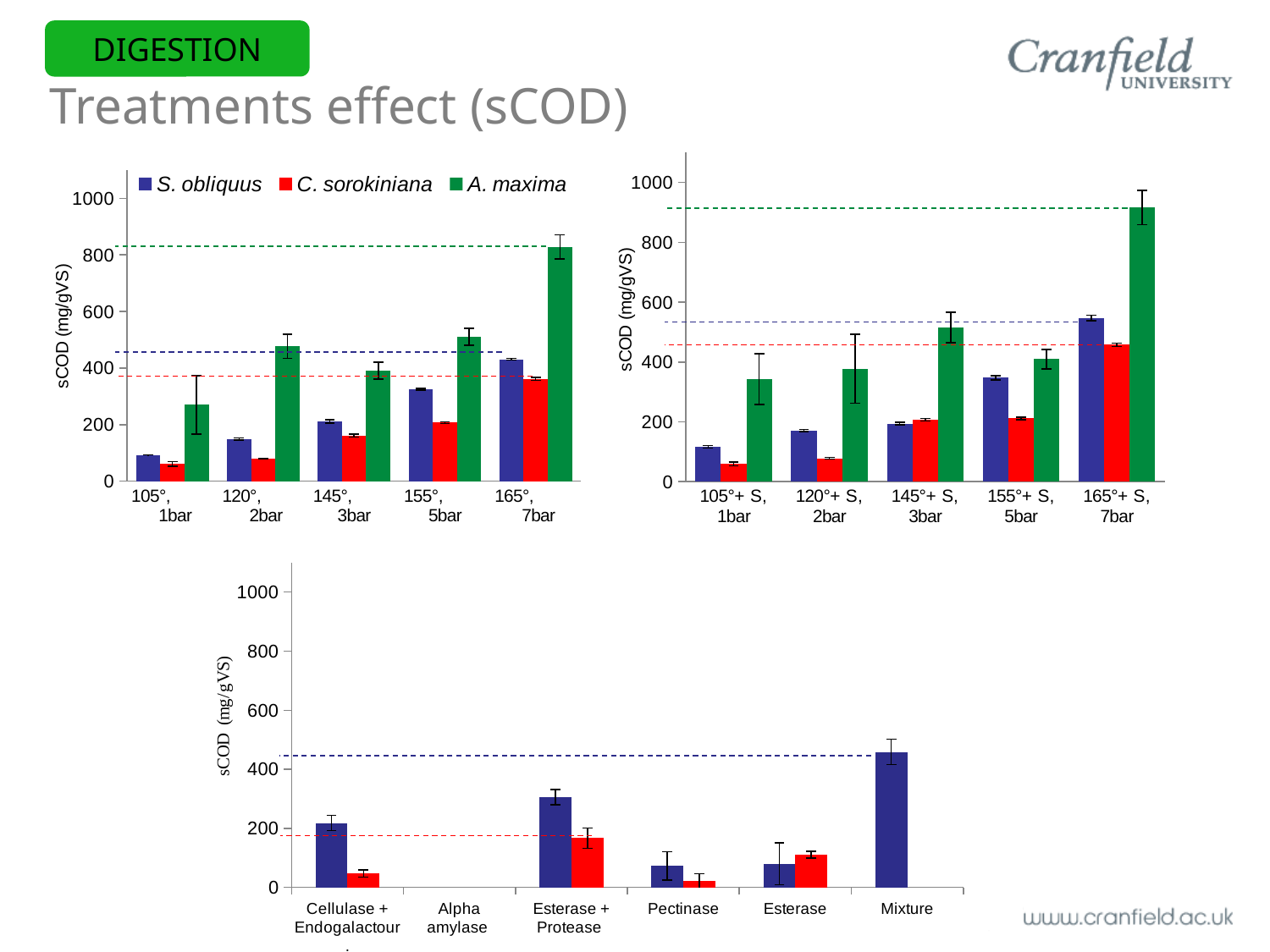
In the bottom chart, is the blue bar for Mixture greater or less than 400? greater In the top-right chart, is the value for A. maxima at 165°+ S, 7bar greater or less than 800? greater What kind of chart is the top-left chart? bar chart In the top-left chart, is the value for A. maxima at 165°, 7bar greater or less than 800? greater In the top-left chart, which category has the highest A. maxima value? 165°, 7bar In the top-right chart, which category has the highest S. obliquus value? 165°+ S, 7bar In the top-left chart, do the S. obliquus values rise or fall from 105°, 1bar to 165°, 7bar? rise In the bottom chart, which category has the highest blue bar? Mixture In the top-left chart, how many temperature/pressure categories are shown on the x axis? 5 In the top-left chart, which series is shown in green? A. maxima In the top-left chart, how many series does the legend list? 3